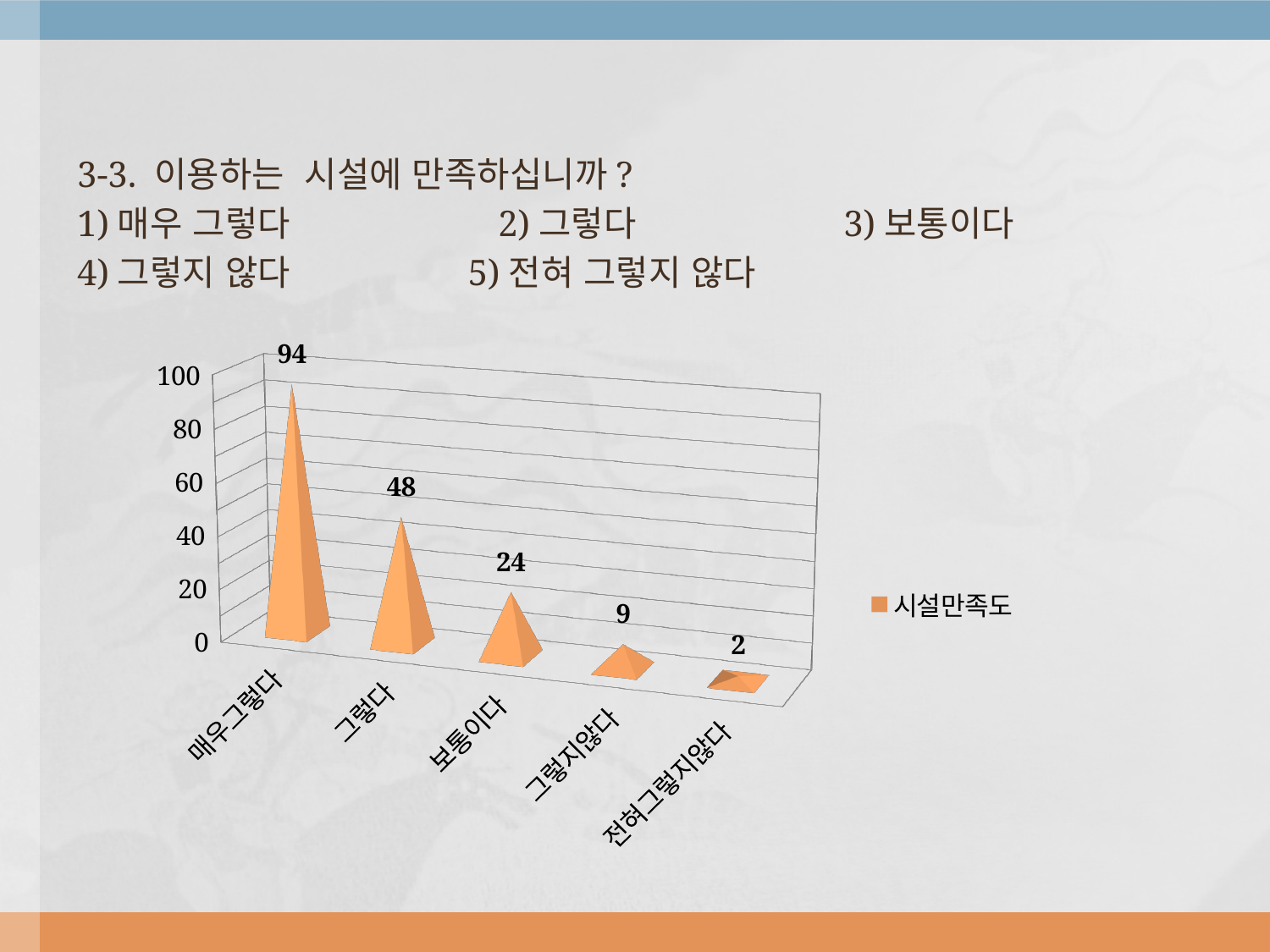
Which category has the lowest value? 전혀그렇지않다 What is the difference between the values for 매우그렇다 and 그렇다? 46 What is the value for 전혀그렇지않다? 2 How many categories are shown on the x axis? 5 Which is larger, the value for 보통이다 or the value for 그렇지않다? 보통이다 What is the value for 그렇다? 48 How many series does the legend list? 1 What kind of chart is shown? bar chart Do the values rise or fall from left to right along the x axis? fall What is the value for 보통이다? 24 What is the value for 매우그렇다? 94 Which category has the highest value? 매우그렇다